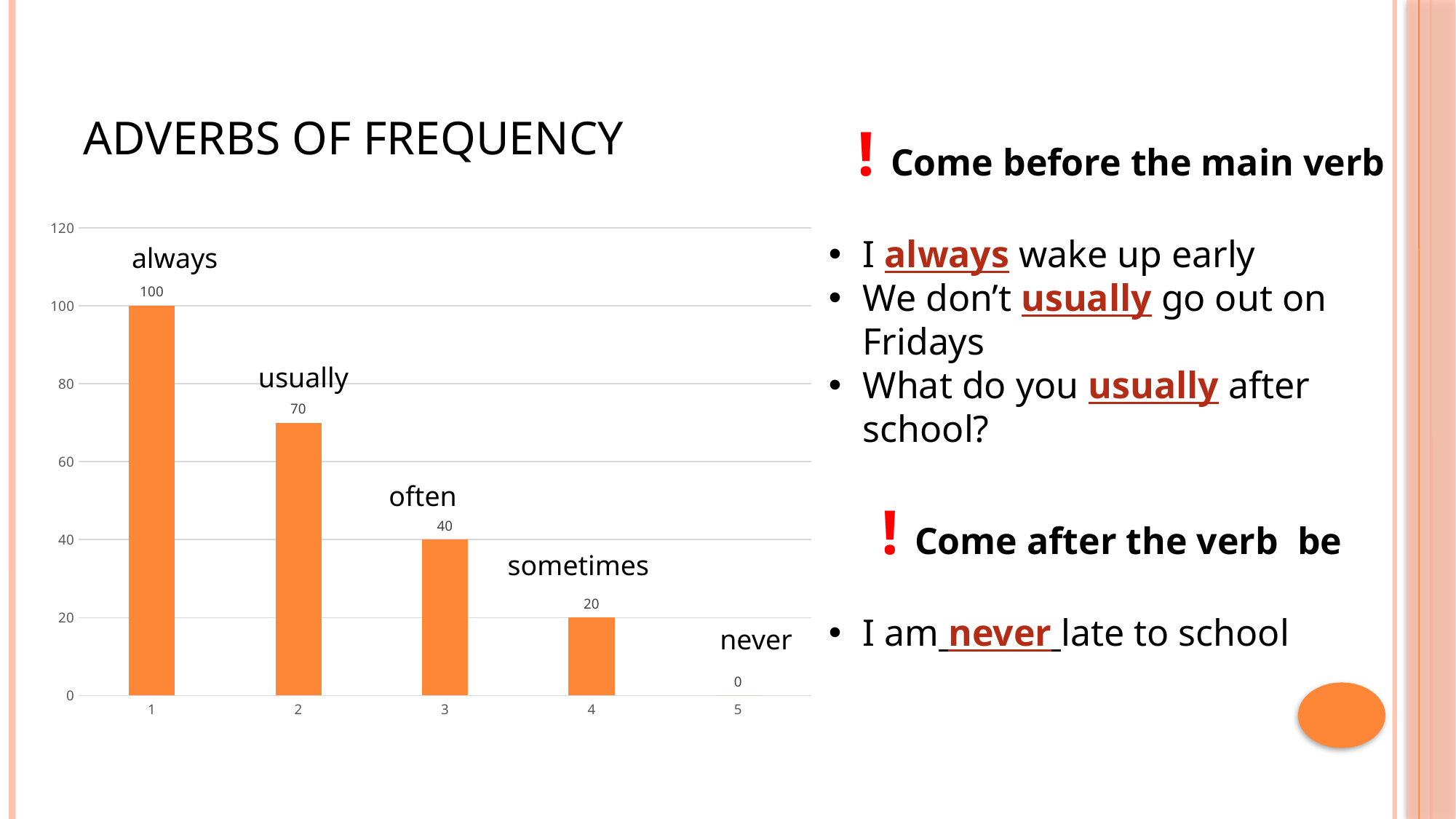
What is the value of the bar labelled "sometimes"? 20 Do the values rise or fall from left to right along the x axis? fall Which adverb has the highest bar? always What is the value of the bar labelled "usually"? 70 Which adverb has the lowest value? never What is the value of the bar labelled "often"? 40 What kind of chart is shown on the slide? bar chart Which is larger, the value for "often" or the value for "sometimes"? often What is the value of the bar labelled "always"? 100 What is the value shown for "never"? 0 How many categories are shown on the x axis? 5 What is the difference between the values for "always" and "usually"? 30